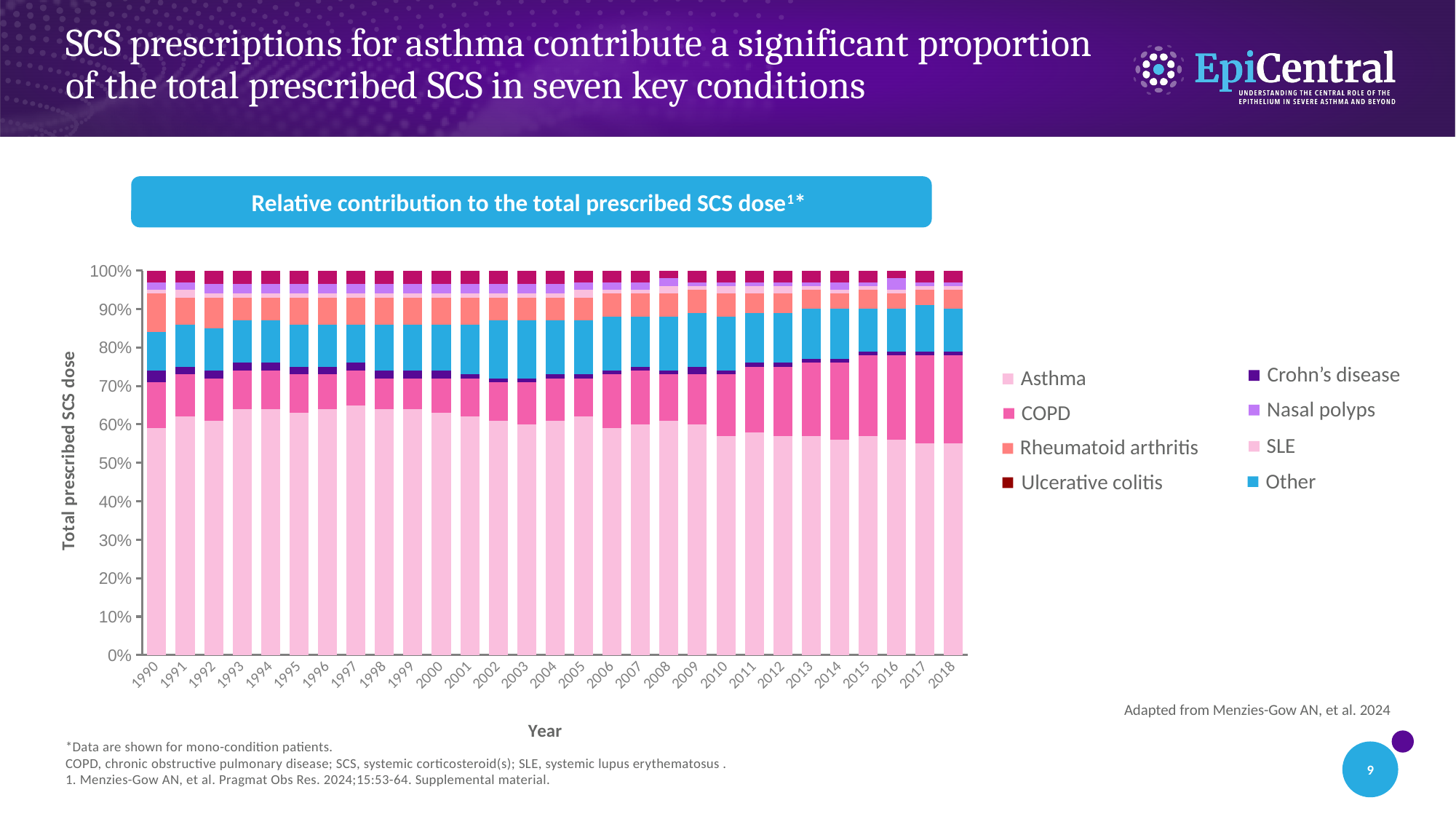
Is the Asthma share of the total prescribed SCS dose in 1990 greater or less than 50%? greater How many years are plotted along the x axis of the chart? 29 What kind of chart is shown on the slide? Stacked bar chart What is the label of the y axis? Total prescribed SCS dose Is the Asthma share of the total prescribed SCS dose in 2014 greater or less than 50%? greater Is the Asthma share of the total prescribed SCS dose in 2018 greater or less than 60%? less How many series does the chart's legend list? 8 What is the first year and the last year shown on the x axis? 1990 and 2018 Which is larger in 2018, the Asthma share or the COPD share of the total prescribed SCS dose? Asthma What is the title of the chart? Relative contribution to the total prescribed SCS dose Which series contributes the largest share of the total prescribed SCS dose in every year shown? Asthma